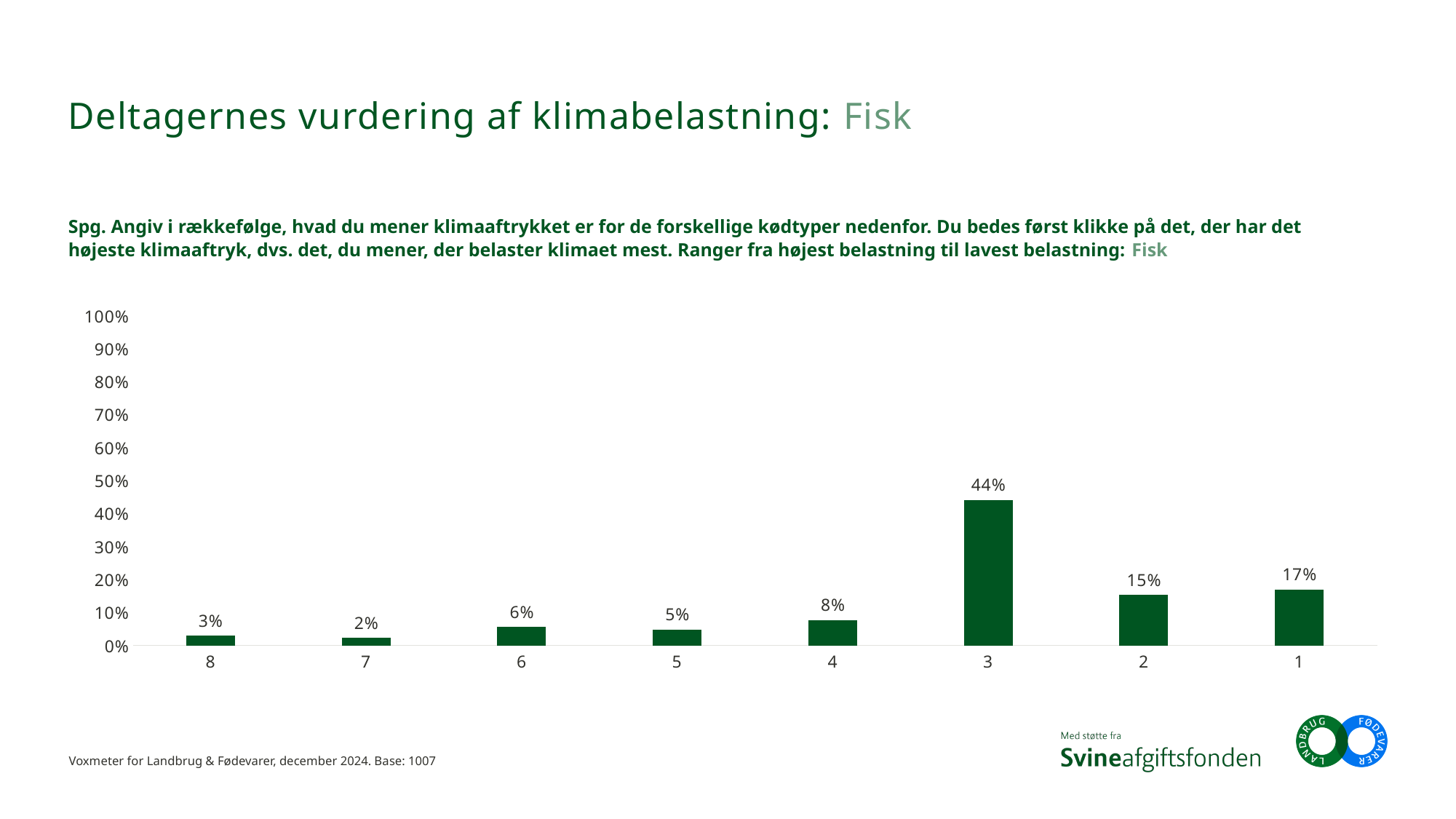
Which category has the lowest value? 7 Which is larger, the value for category 6 or the value for category 5? 6 What is the value for category 7? 2% Is the value for category 3 greater or less than 40%? greater Which category has the highest value? 3 What is the value for category 3? 44% How many categories are shown on the x axis? 8 What kind of chart is shown on the slide? bar chart What is the value for category 4? 8% What is the difference between the values for category 2 and category 8? 12% What is the difference between the values for category 3 and category 1? 27% What is the value for category 1? 17%